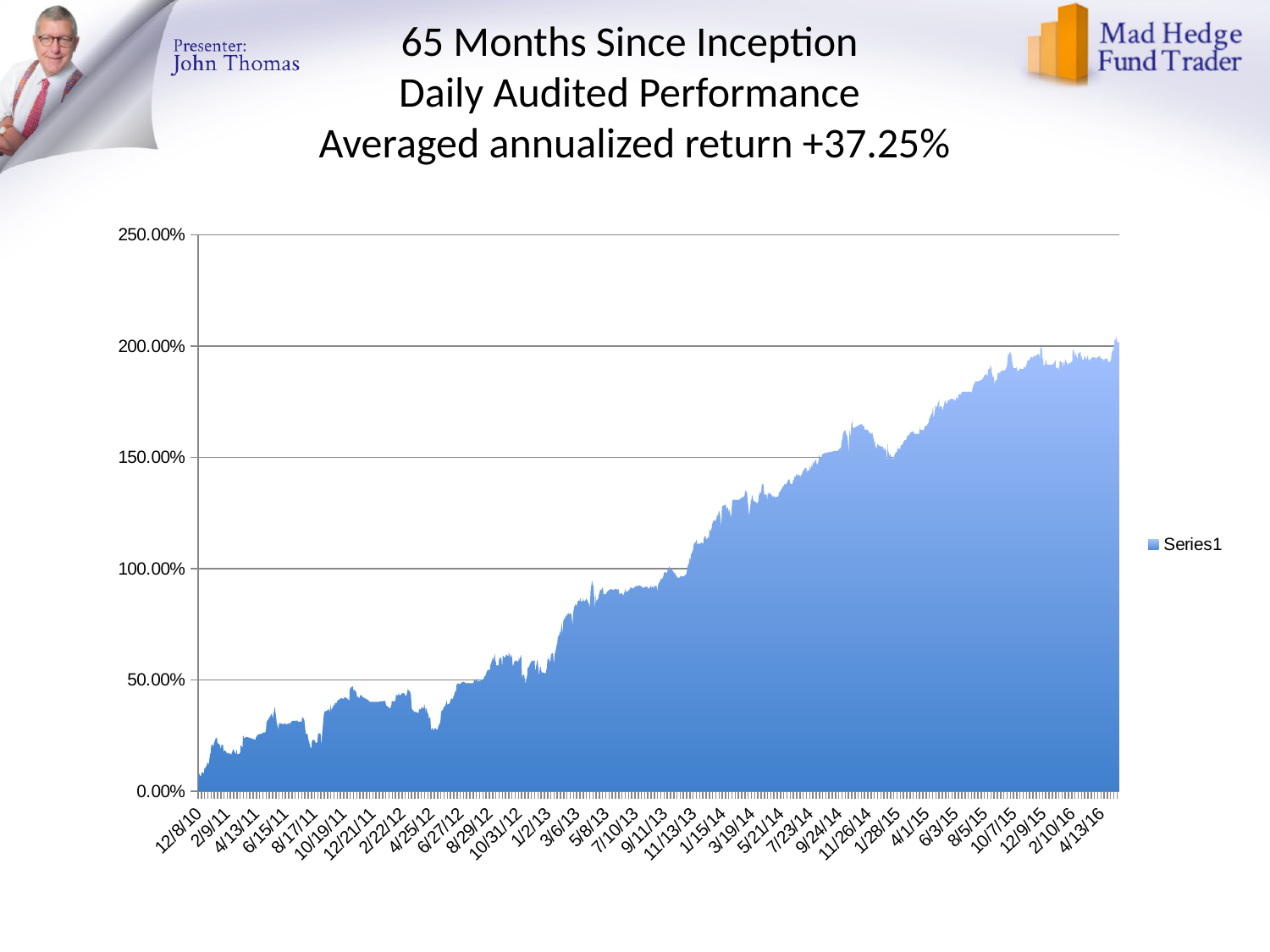
Is the value for 3/6/13 greater or less than 100.00%? less Is the value for 4/13/16 greater or less than 150.00%? greater Overall, do the values rise or fall from 12/8/10 to 4/13/16? rise How many series does the legend list? 1 What is the name of the series shown in the legend? Series1 Is the value for 12/8/10 greater or less than 50.00%? less What kind of chart is shown on the slide? area chart What is the highest value shown on the vertical axis? 250.00% Which of the two dates has the larger value, 2/9/11 or 4/13/16? 4/13/16